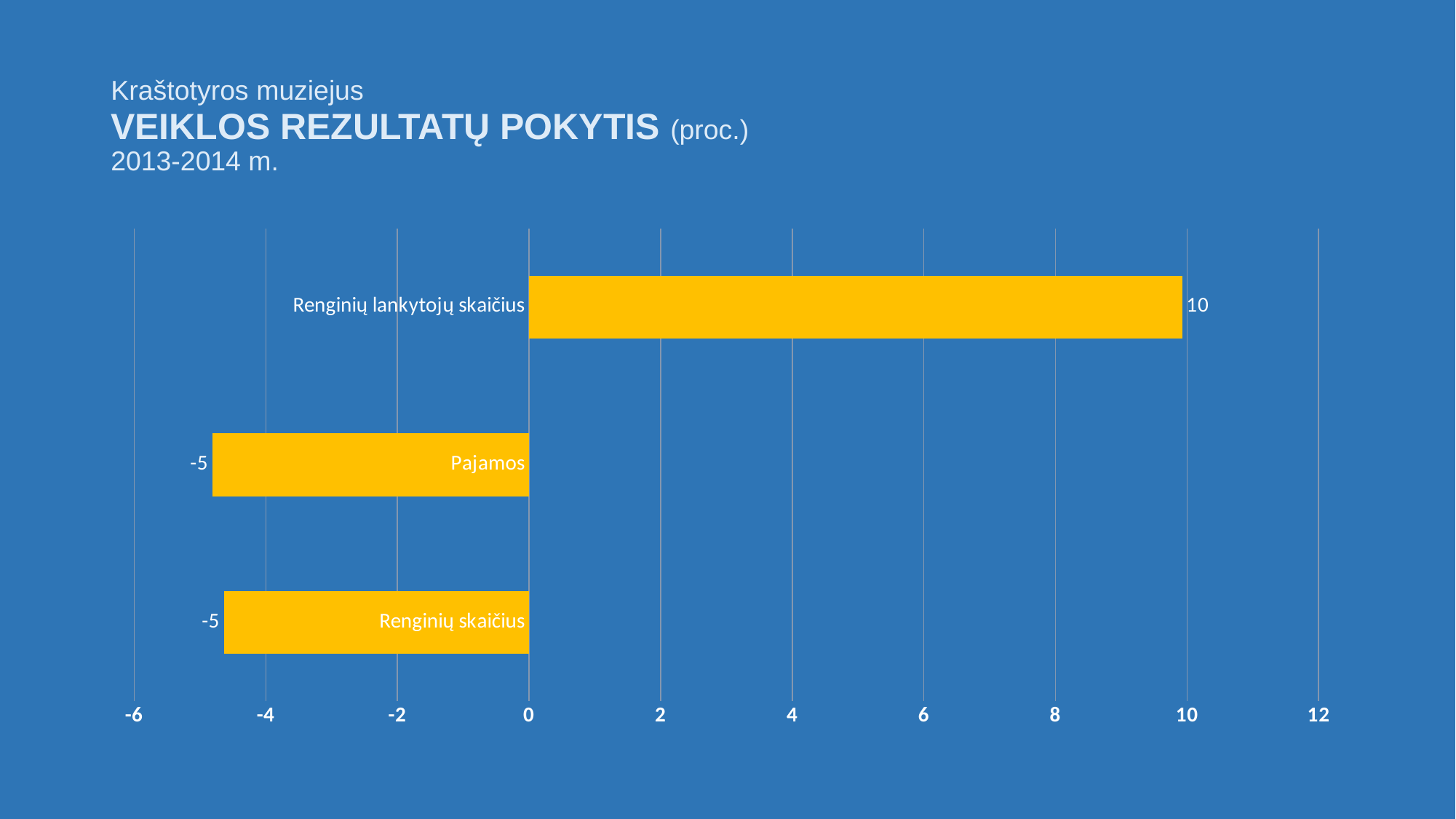
How many categories have a negative value? 2 What kind of chart is shown on the slide? bar chart Is the value for Pajamos greater or less than 0? less What is the value for Renginių lankytojų skaičius? 10 What period does the chart title refer to? 2013-2014 m. How many categories are shown in the chart? 3 Is the value for Renginių lankytojų skaičius greater or less than 8? greater What is the value for Renginių skaičius? -5 Which is larger, the value for Renginių lankytojų skaičius or the value for Renginių skaičius? Renginių lankytojų skaičius Which category has the highest value? Renginių lankytojų skaičius What is the difference between the values for Renginių lankytojų skaičius and Pajamos? 15 What is the value for Pajamos? -5